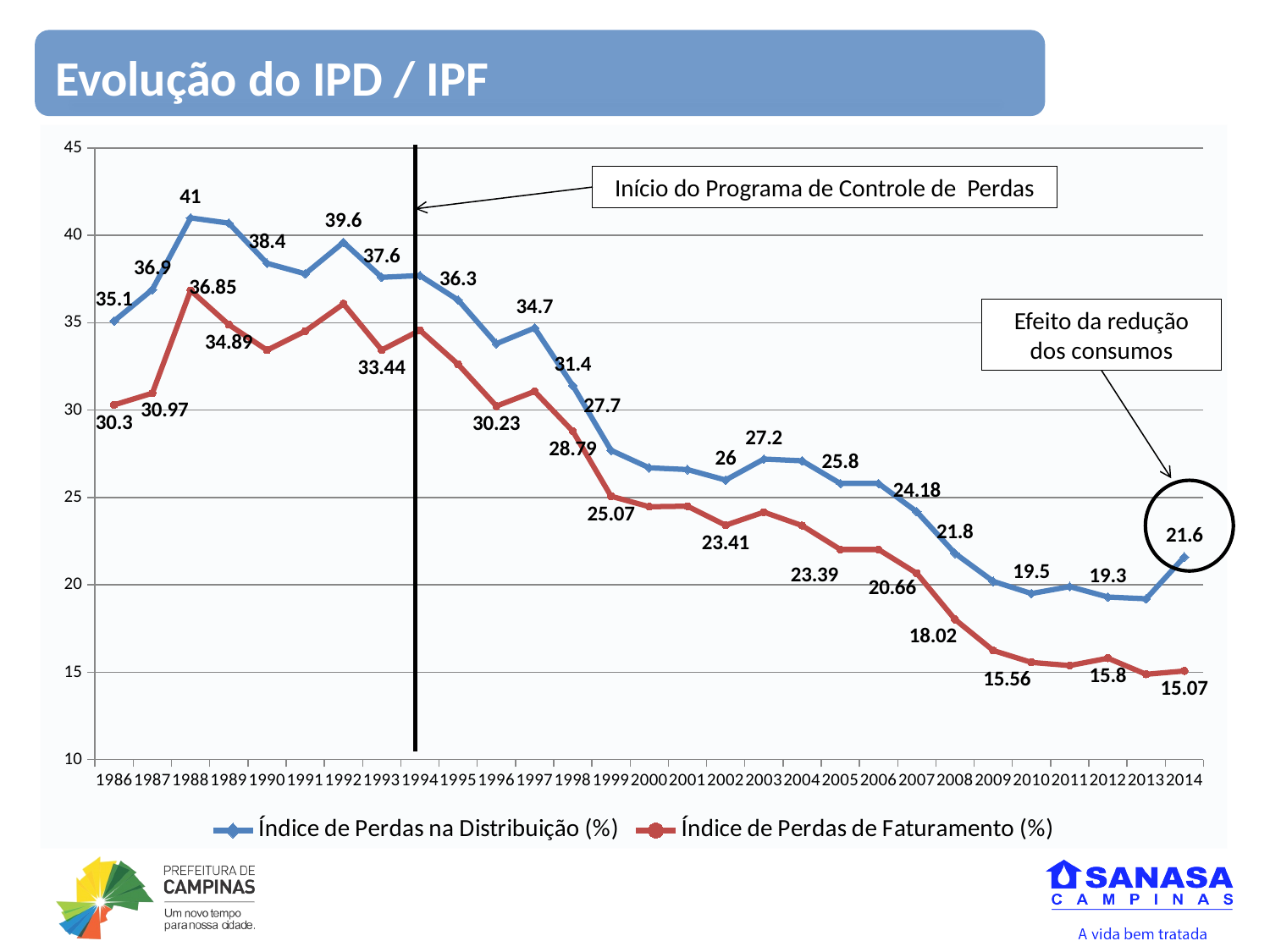
What is the value of the Índice de Perdas na Distribuição (%) in 2014? 21.6 What is the value of the Índice de Perdas de Faturamento (%) in 2014? 15.07 In 1986, which series has the higher value: Índice de Perdas na Distribuição (%) or Índice de Perdas de Faturamento (%)? Índice de Perdas na Distribuição (%) What is the value of the Índice de Perdas de Faturamento (%) in 1986? 30.3 Overall, do the values of the Índice de Perdas de Faturamento (%) rise or fall from 1994 to 2014? fall What is the difference between the Índice de Perdas na Distribuição (%) in 1988 and in 1986? 5.9 How many years are shown on the x axis? 29 What kind of chart is shown on the slide? line chart Is the value of the Índice de Perdas de Faturamento (%) in 2005 greater or less than 25? less How many series does the legend list? 2 In which year does the Índice de Perdas na Distribuição (%) reach its highest value? 1988 What is the value of the Índice de Perdas na Distribuição (%) in 1988? 41